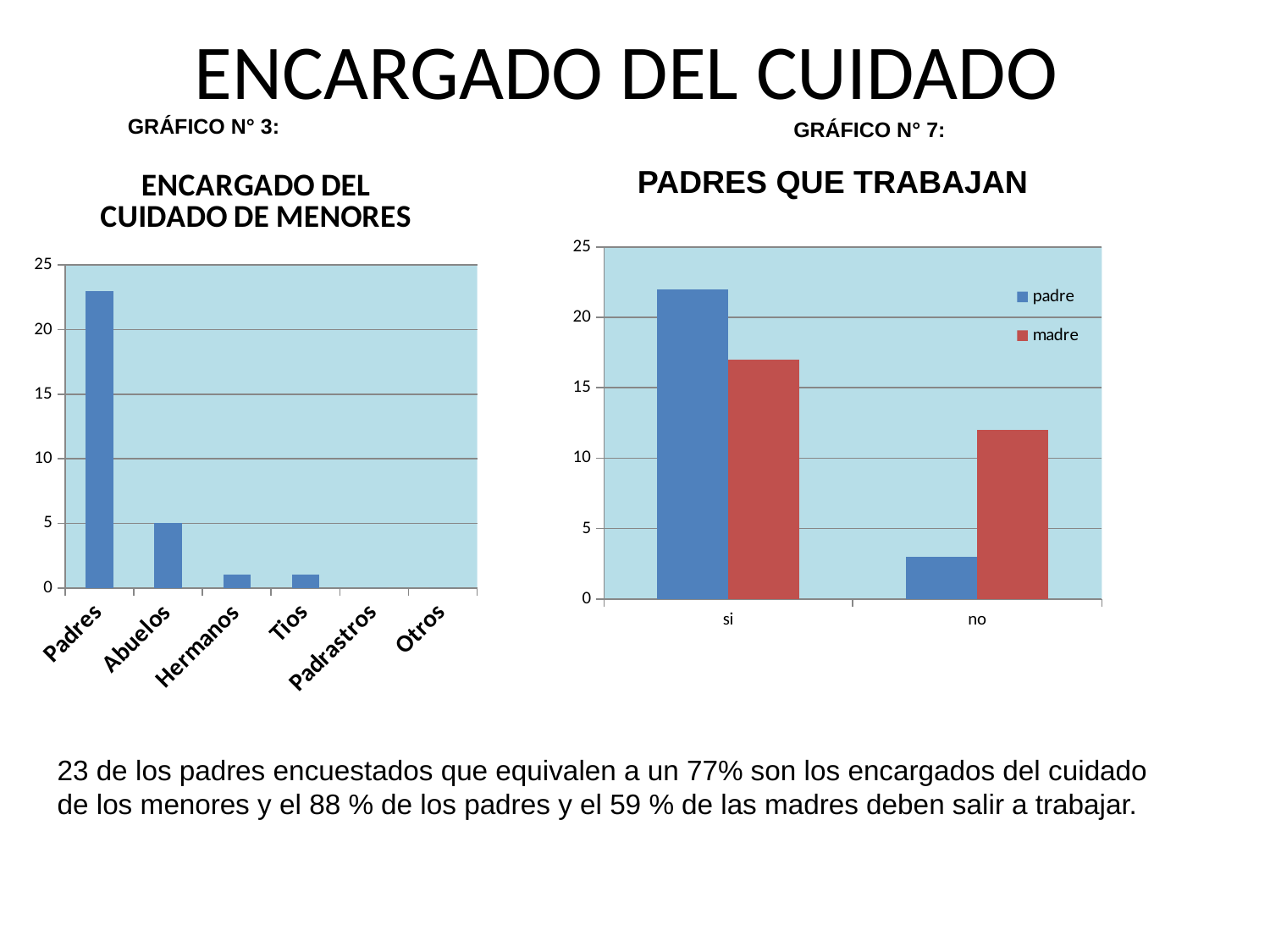
In the chart titled "ENCARGADO DEL CUIDADO DE MENORES", is the value for Padres greater or less than 20? greater In the chart titled "PADRES QUE TRABAJAN", is the value for padre in the "no" category greater or less than 5? less What kind of chart is the chart titled "ENCARGADO DEL CUIDADO DE MENORES"? bar chart In the chart titled "PADRES QUE TRABAJAN", is the value for padre in the "si" category greater or less than 20? greater In the chart titled "PADRES QUE TRABAJAN", what are the two series named in the legend? padre and madre In the chart titled "ENCARGADO DEL CUIDADO DE MENORES", which is larger, the value for Abuelos or the value for Hermanos? Abuelos In the chart titled "ENCARGADO DEL CUIDADO DE MENORES", what is the value for Abuelos? 5 In the chart titled "ENCARGADO DEL CUIDADO DE MENORES", which category has the highest value? Padres In the chart titled "PADRES QUE TRABAJAN", which is larger for the "no" category, padre or madre? madre In the chart titled "ENCARGADO DEL CUIDADO DE MENORES", how many categories are shown on the x axis? 6 In the chart titled "PADRES QUE TRABAJAN", which colour represents the madre series? red In the chart titled "PADRES QUE TRABAJAN", how many series does the legend list? 2